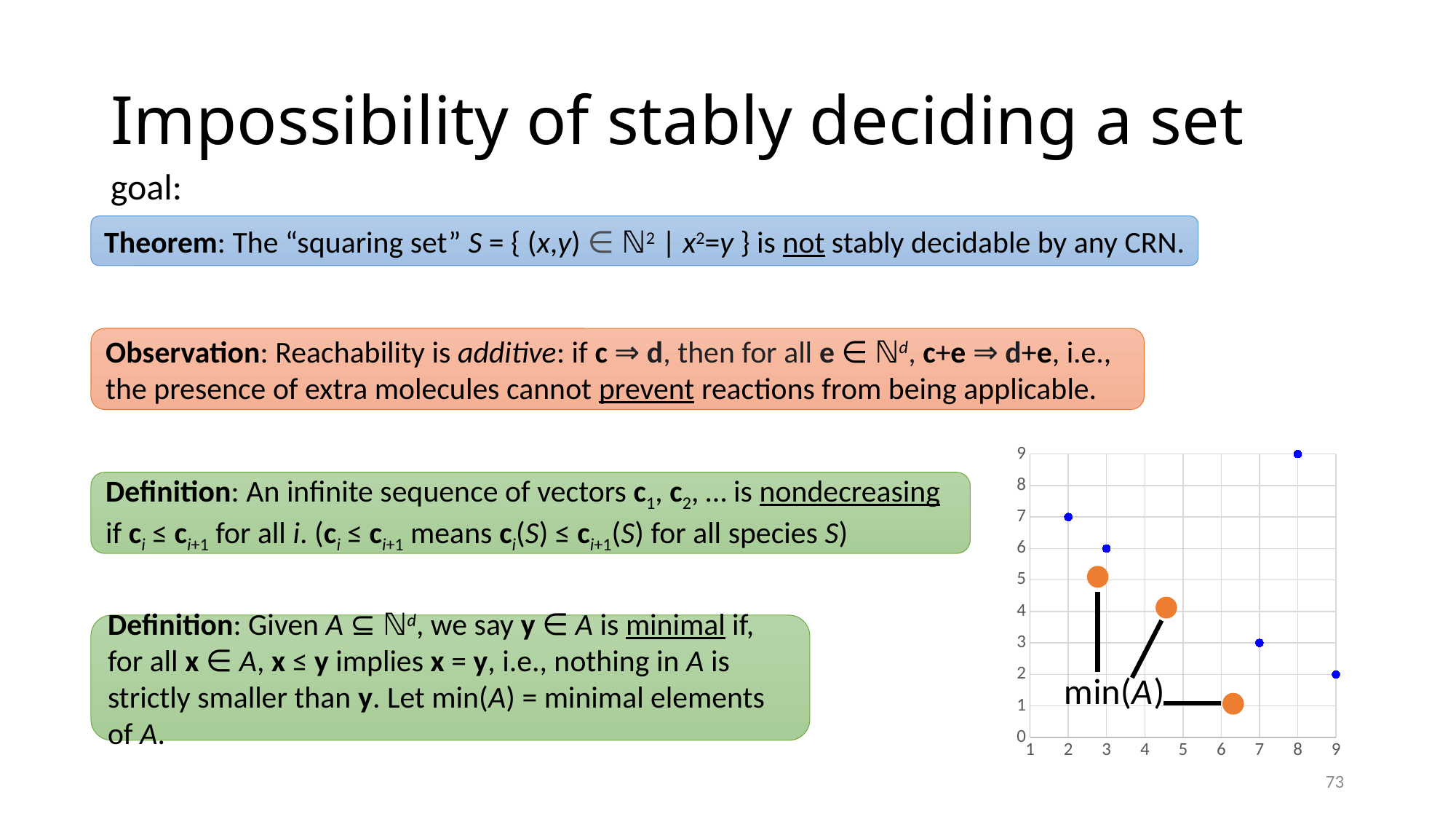
At which x value is the blue point with the highest y value? 8 At which x value is the blue point with the lowest y value? 9 How many small blue points are plotted on the chart? 5 What is the y value of the blue point at x = 9? 2 What is the y value of the blue point at x = 3? 6 What is the y value of the blue point at x = 2? 7 Is the y value of the rightmost orange point greater or less than 2? less What kind of chart is shown on the right of the slide? scatter chart How many large orange points are plotted on the chart? 3 Which blue point has a larger y value, the one at x = 2 or the one at x = 7? x = 2 What is the y value of the blue point at x = 7? 3 What label is written next to the orange points on the chart? min(A)